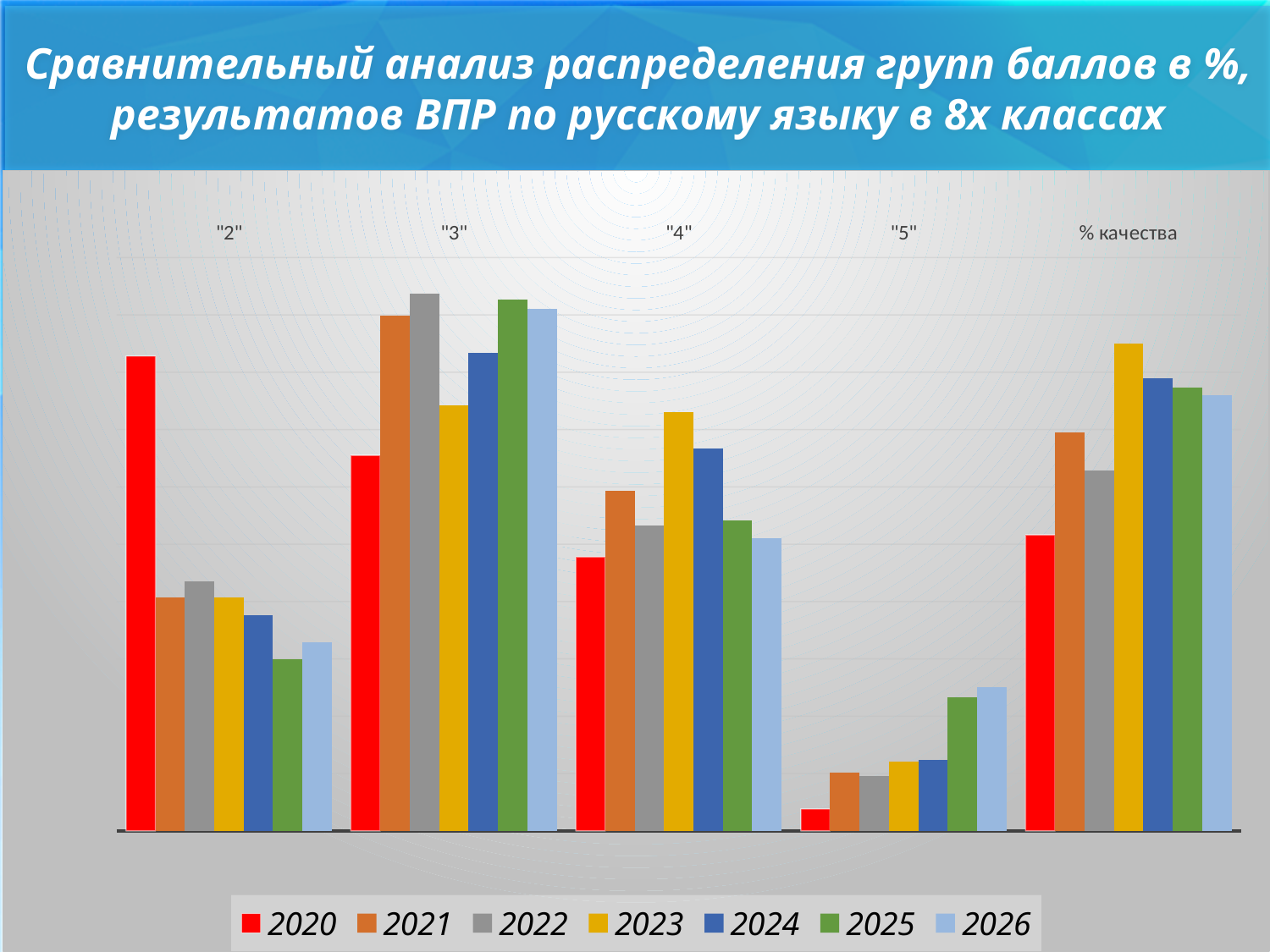
In the "2" category, which year has the lowest value? 2025 What kind of chart is shown on the slide? bar chart Which colour represents the 2020 series in the legend? red How many series does the legend list? 7 In the "5" category, which is larger: the value for 2025 or the value for 2021? 2025 In the "4" category, which year has the highest value? 2023 Across the years 2020 to 2026, do the values in the "5" category generally rise or fall? rise In the "2" category, which year has the highest value? 2020 In the "5" category, which year has the lowest value? 2020 In the "3" category, which year has the lowest value? 2020 In the "% качества" category, which year has the highest value? 2023 How many categories are shown along the x axis? 5